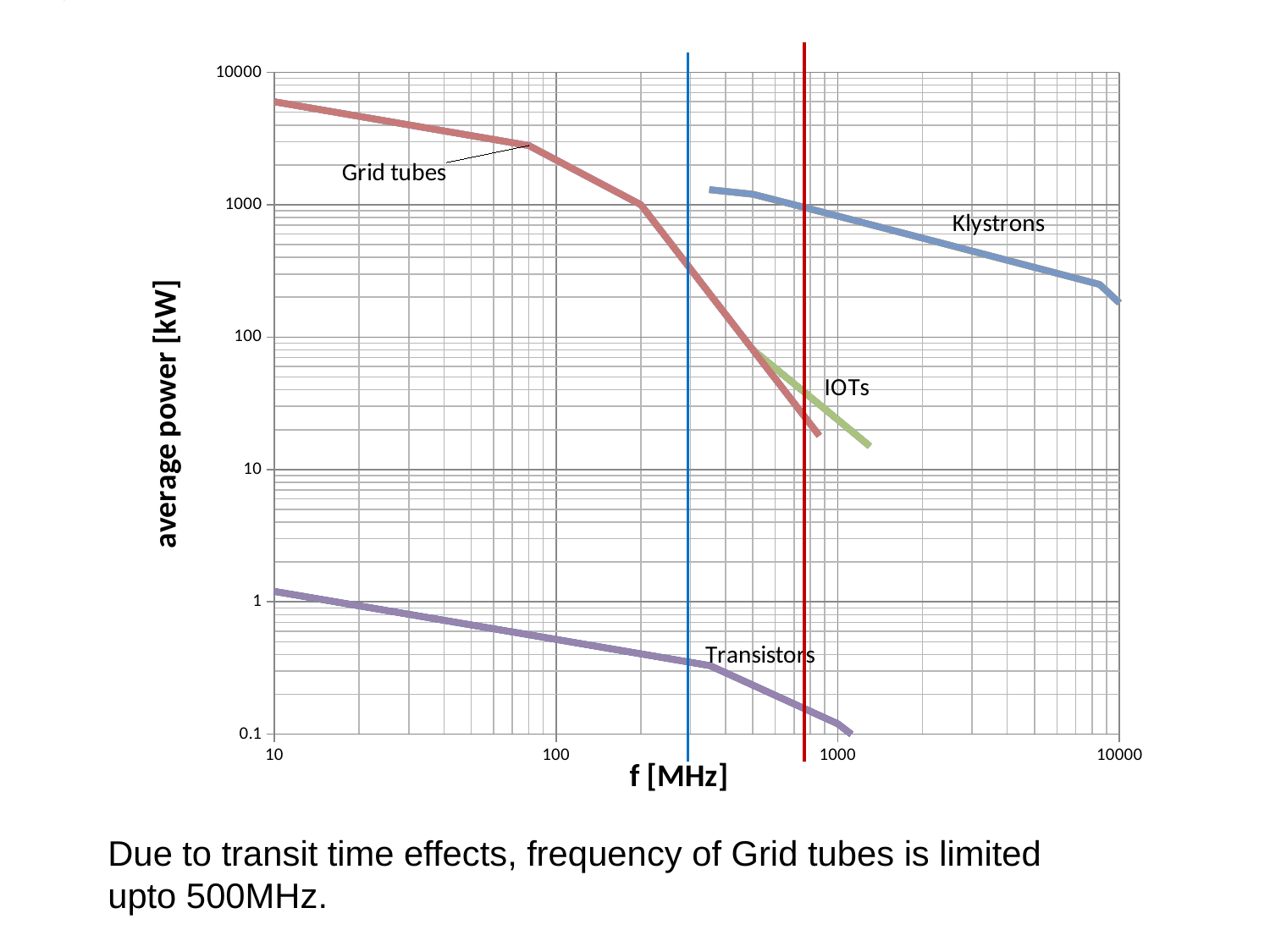
Does the average power of Klystrons rise or fall as frequency increases? fall Which series has the highest average power at 10 MHz? Grid tubes Is the average power of IOTs at 1000 MHz greater or less than 100 kW? less What kind of chart is shown on the slide? line chart Does the average power of Grid tubes rise or fall as frequency increases? fall Is the average power of Klystrons at 10000 MHz greater or less than 1000 kW? less What is the title of the vertical axis? average power [kW] Which series has the lowest average power across the chart? Transistors How many labelled series (lines) are plotted on the chart? 4 What is the title of the horizontal axis? f [MHz] At 1000 MHz, which series has the higher average power, Klystrons or Transistors? Klystrons Is the average power of Grid tubes at 10 MHz greater or less than 1000 kW? greater